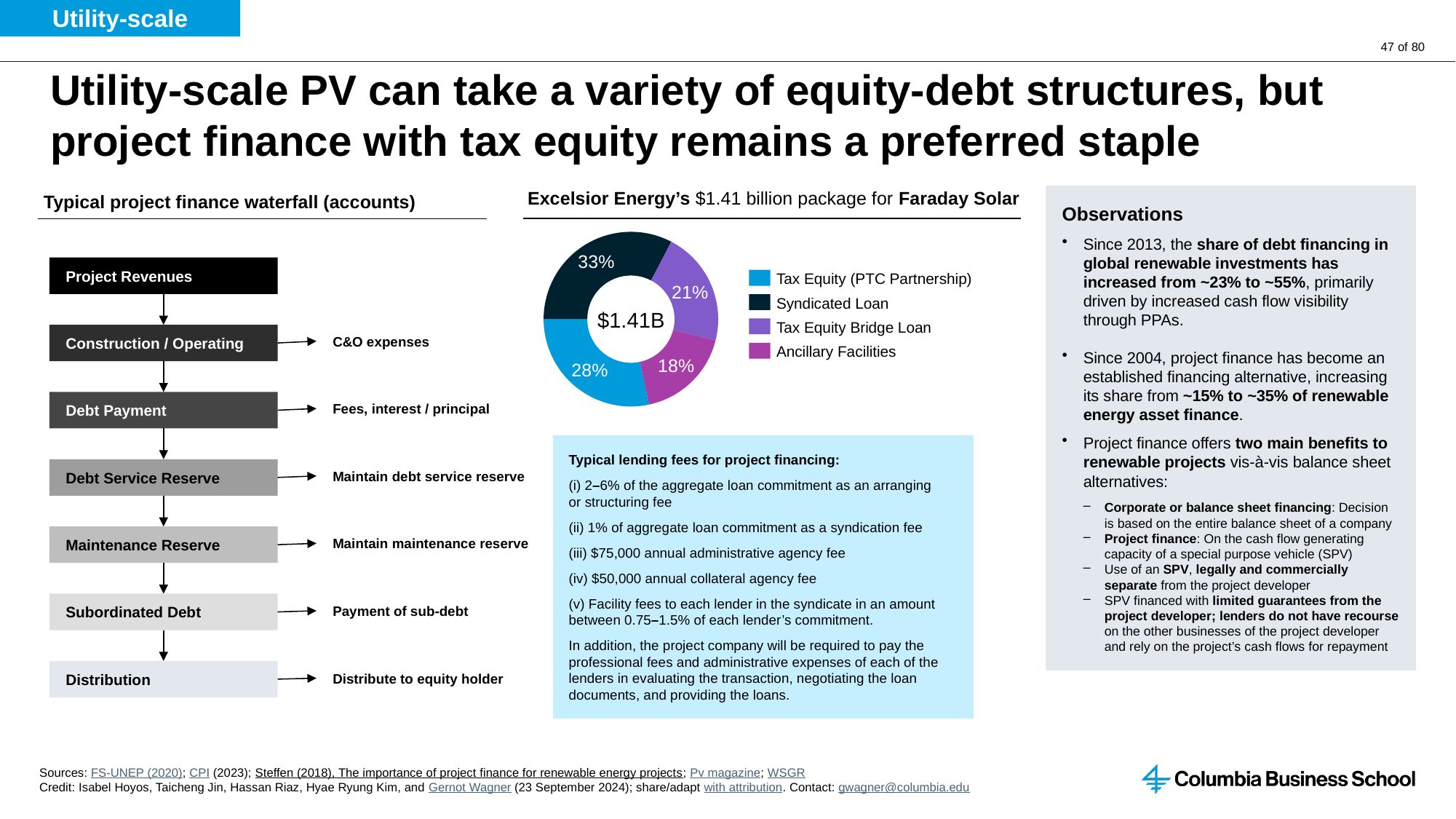
How many slices does the Faraday Solar package chart have? 4 In the Faraday Solar package chart, what share is Syndicated Loan? 33% In the Faraday Solar package chart, what share is Tax Equity (PTC Partnership)? 28% What total value is shown in the center of the Faraday Solar package chart? $1.41B In the Faraday Solar package chart, what share is Ancillary Facilities? 18% In the Faraday Solar package chart, what colour represents Syndicated Loan? Dark navy Which component has the largest share of the Faraday Solar package? Syndicated Loan In the Faraday Solar package chart, what share is Tax Equity Bridge Loan? 21% Which component has the smallest share of the Faraday Solar package? Ancillary Facilities What kind of chart is used to show Excelsior Energy's $1.41 billion package for Faraday Solar? Pie chart (donut) In the Faraday Solar package chart, which is larger: Tax Equity Bridge Loan or Ancillary Facilities? Tax Equity Bridge Loan In the Faraday Solar package chart, how many percentage points larger is Syndicated Loan than Tax Equity (PTC Partnership)? 5 percentage points